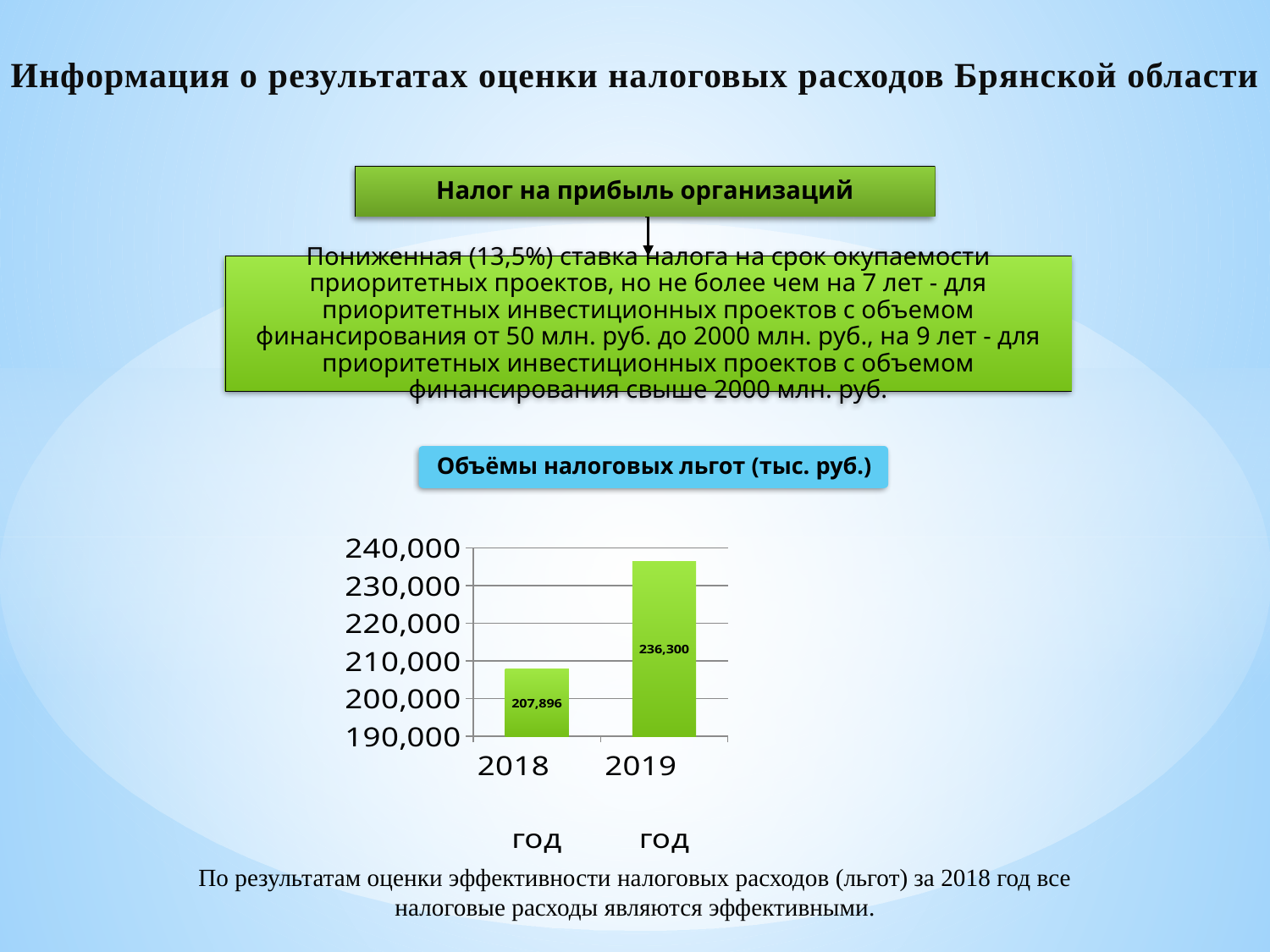
Which is larger, the value for 2018 год or the value for 2019 год? 2019 год Which year has the lowest value in the chart? 2018 год Is the value for 2018 год greater or less than 210,000? less How many bars are plotted in the chart? 2 Which year has the highest value in the chart? 2019 год What is the title shown above the chart? Объёмы налоговых льгот (тыс. руб.) Is the value for 2019 год greater or less than 230,000? greater What is the difference between the values for 2019 год and 2018 год? 28,404 What is the value for 2019 год in the chart? 236,300 What kind of chart is shown on the slide? bar chart What is the value for 2018 год in the chart? 207,896 Do the values rise or fall from 2018 to 2019? rise